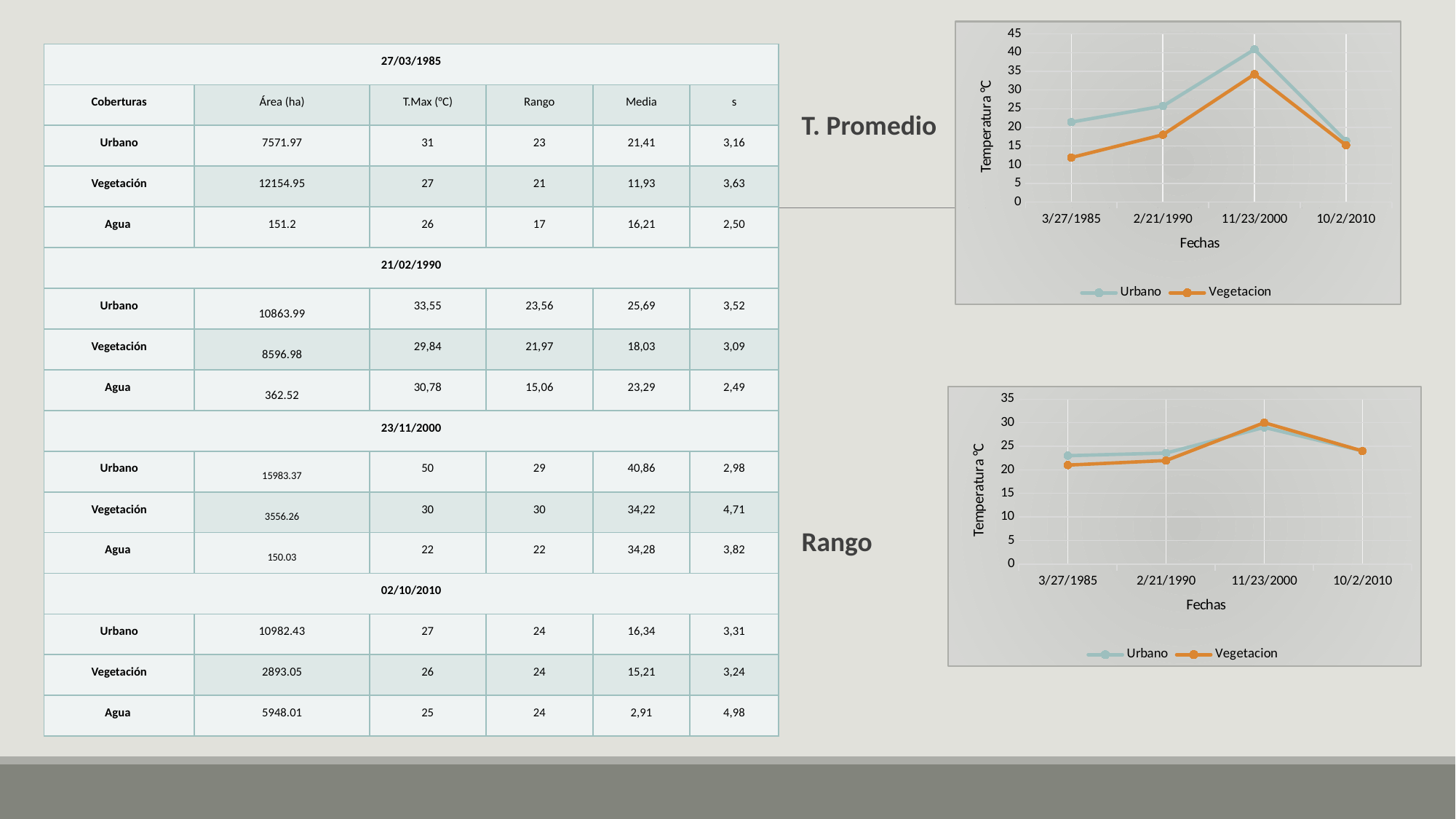
In the T. Promedio chart, at which date does the Urbano series reach its highest value? 11/23/2000 In the Rango chart, is the Urbano value at 3/27/1985 greater or less than 20? greater In the T. Promedio chart, what kind of chart is shown? line chart In the T. Promedio chart, what is the label of the y axis? Temperatura °C In the T. Promedio chart, is the Vegetacion value at 3/27/1985 greater or less than 15? less In the Rango chart, how many series does the legend list? 2 In the Rango chart, at which date does the Vegetacion series reach its highest value? 11/23/2000 In the T. Promedio chart, is the Urbano value at 11/23/2000 greater or less than 40? greater In the T. Promedio chart, how many dates are shown on the x axis? 4 In the T. Promedio chart, which series is higher at 2/21/1990, Urbano or Vegetacion? Urbano In the T. Promedio chart, at which date is the Vegetacion series lowest? 3/27/1985 In the Rango chart, what is the Vegetacion value at 11/23/2000? 30